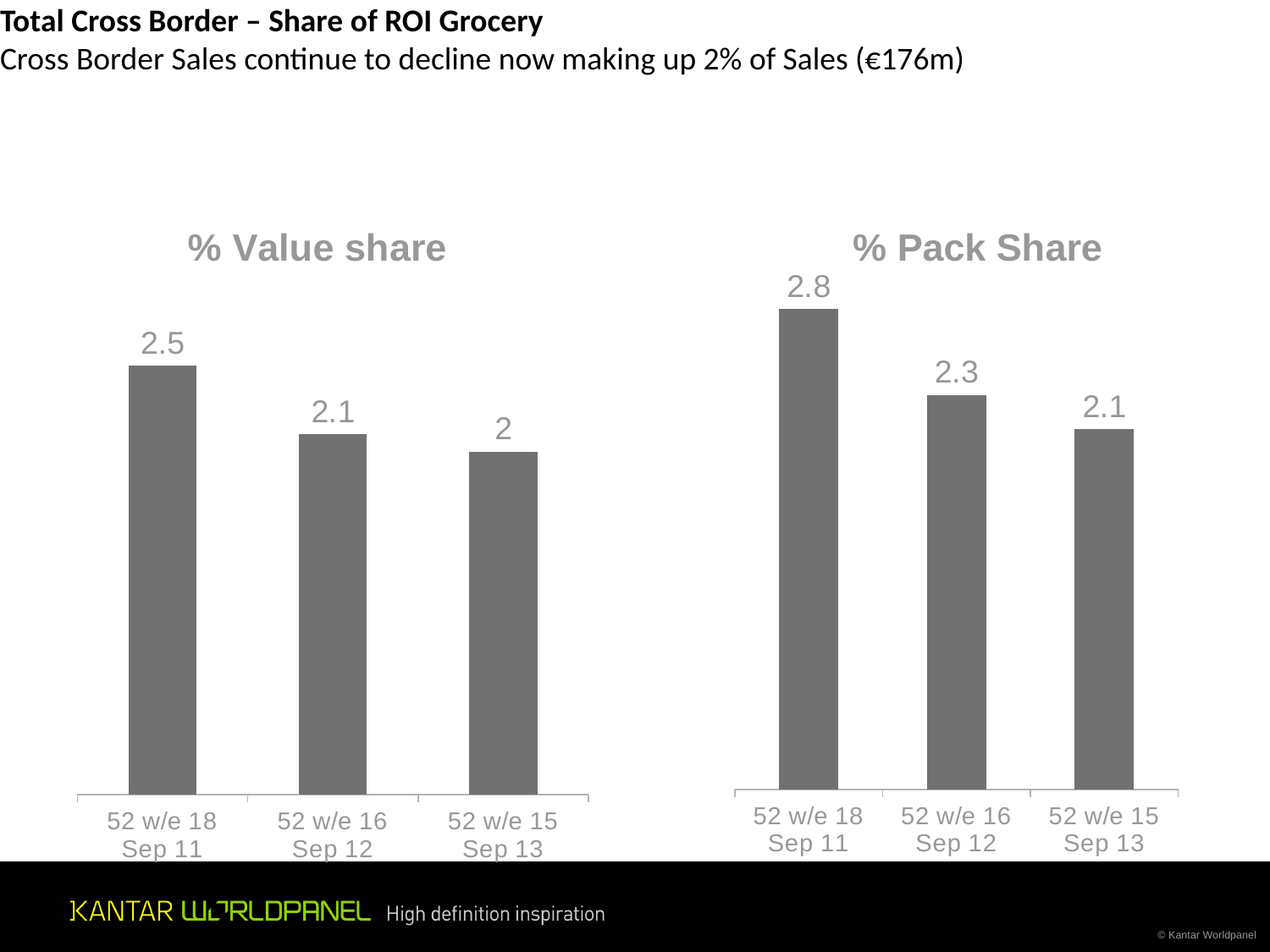
In the '% Value share' chart, which period has the lowest value? 52 w/e 15 Sep 13 In the '% Value share' chart, what is the value for 52 w/e 15 Sep 13? 2 In the '% Pack Share' chart, what is the value for 52 w/e 18 Sep 11? 2.8 In the '% Value share' chart, what is the value for 52 w/e 18 Sep 11? 2.5 In the '% Pack Share' chart, what is the value for 52 w/e 16 Sep 12? 2.3 How many periods are shown in the '% Value share' chart? 3 In the '% Value share' chart, do the values rise or fall from 52 w/e 18 Sep 11 to 52 w/e 15 Sep 13? Fall In the '% Value share' chart, what is the difference between the values for 52 w/e 18 Sep 11 and 52 w/e 16 Sep 12? 0.4 In the '% Pack Share' chart, what is the difference between the values for 52 w/e 18 Sep 11 and 52 w/e 15 Sep 13? 0.7 Which is larger: the 52 w/e 16 Sep 12 value in the '% Value share' chart or the 52 w/e 16 Sep 12 value in the '% Pack Share' chart? % Pack Share What type of chart is the '% Pack Share' chart? Bar chart In the '% Pack Share' chart, which period has the highest value? 52 w/e 18 Sep 11